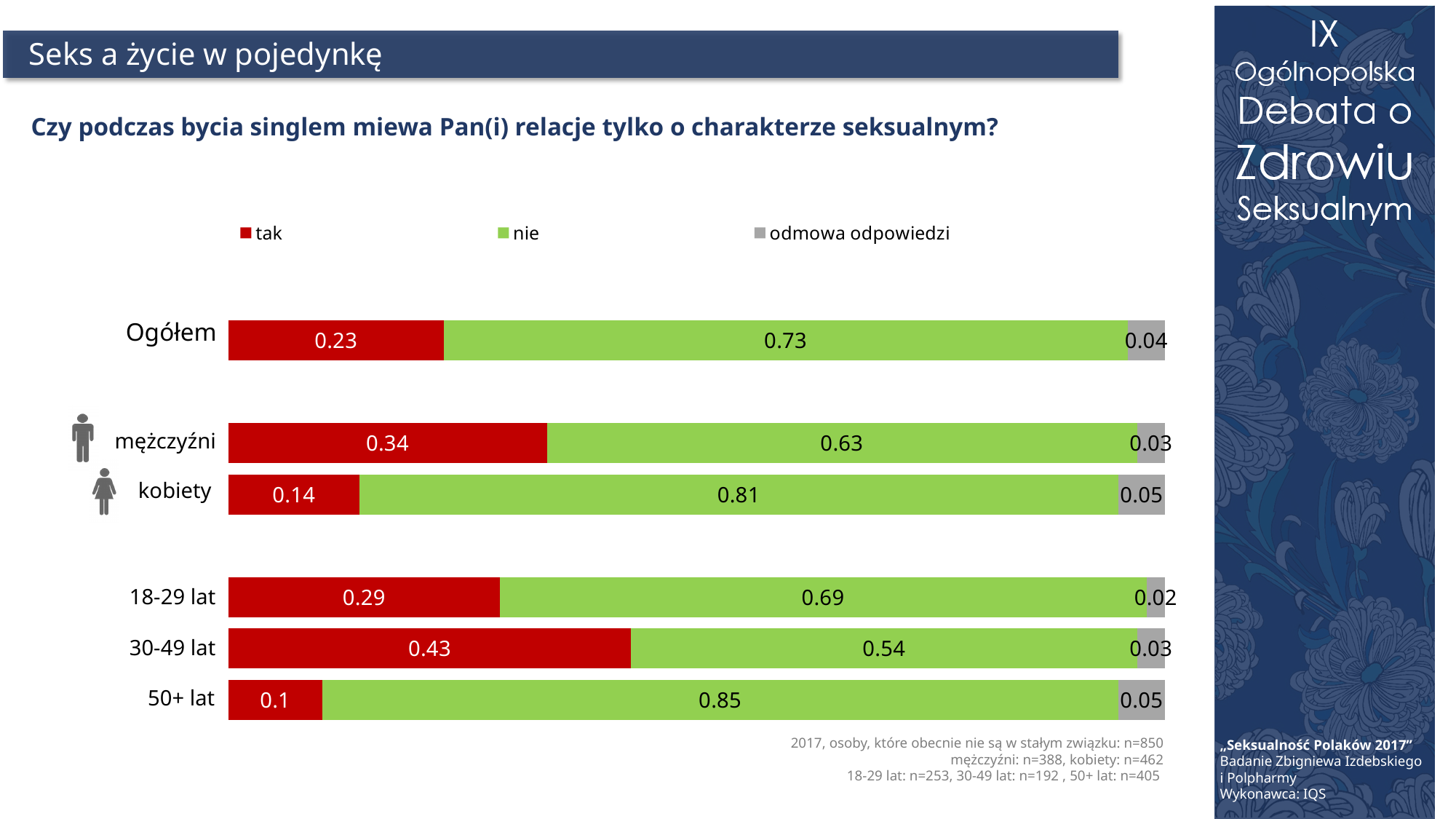
What is the value for "odmowa odpowiedzi" in the 18-29 lat category? 0.02 What is the value for "nie" among kobiety? 0.81 How many series does the legend list? 3 How many categories are shown on the chart? 6 What kind of chart is shown on the slide? Stacked bar chart Which is larger: the "nie" value for 18-29 lat or for 30-49 lat? 18-29 lat Which category has the highest value for "tak"? 30-49 lat Which category has the lowest value for "tak"? 50+ lat What is the value for "tak" in the Ogółem category? 0.23 What is the total of the stacked bar for 50+ lat? 1 What is the difference between the "tak" values for mężczyźni and kobiety? 0.2 Which colour represents the "nie" series in the legend? Green